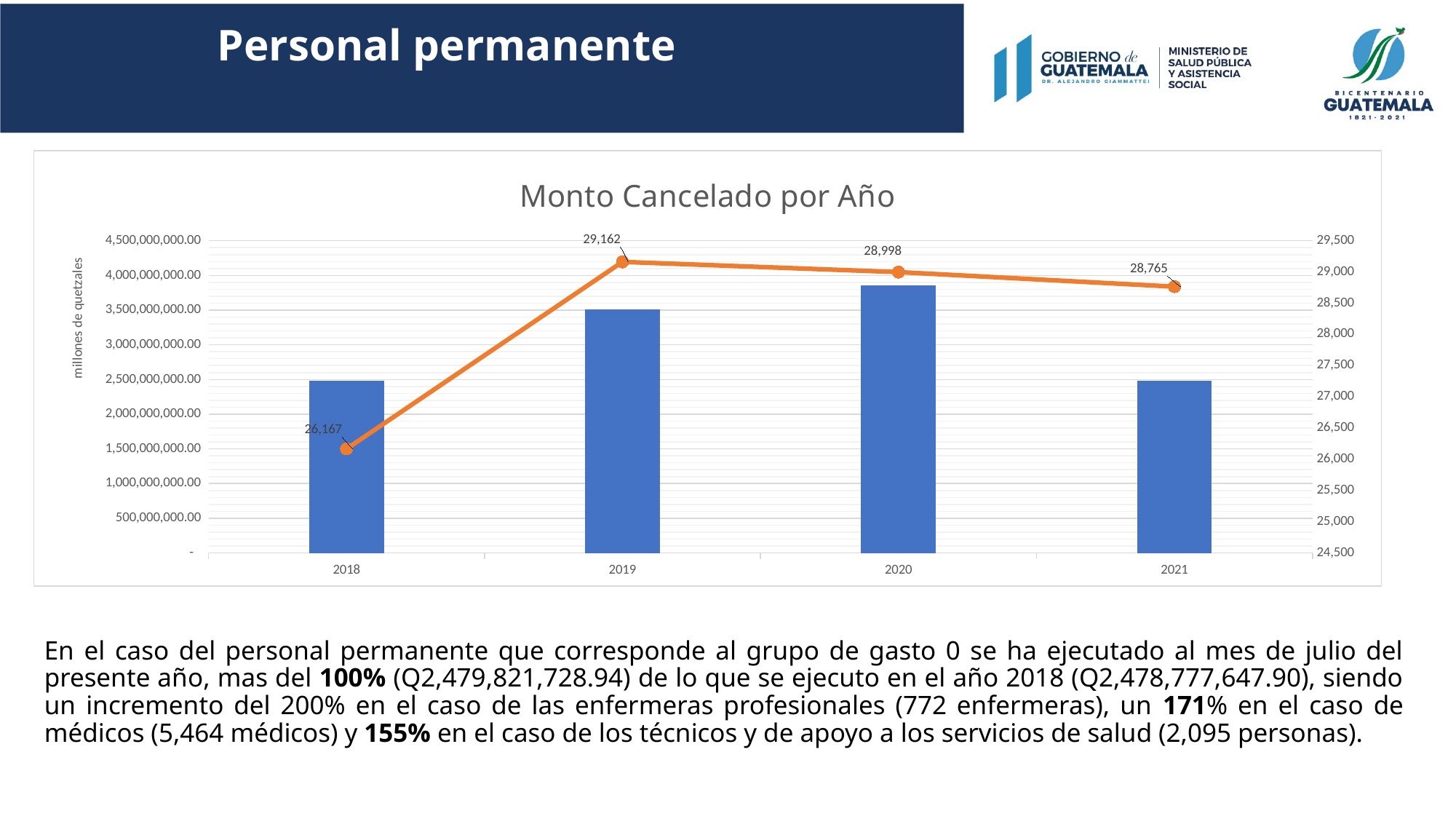
What is the difference between the line values for 2020 and 2021? 233 Is the bar value for 2018 greater or less than 3,000,000,000.00? less In which year does the line series reach its highest value? 2019 What is the title of the chart on the slide? Monto Cancelado por Año In which year does the line series have its lowest value? 2018 What is the difference between the line values for 2019 and 2018? 2,995 Which year has the taller bar, 2019 or 2020? 2020 Is the bar value for 2020 greater or less than 3,500,000,000.00? greater What is the line value shown for 2018 in the 'Monto Cancelado por Año' chart? 26,167 How many years are shown on the x axis of the chart? 4 What is the line value shown for 2019 in the 'Monto Cancelado por Año' chart? 29,162 What is the line value shown for 2021 in the 'Monto Cancelado por Año' chart? 28,765